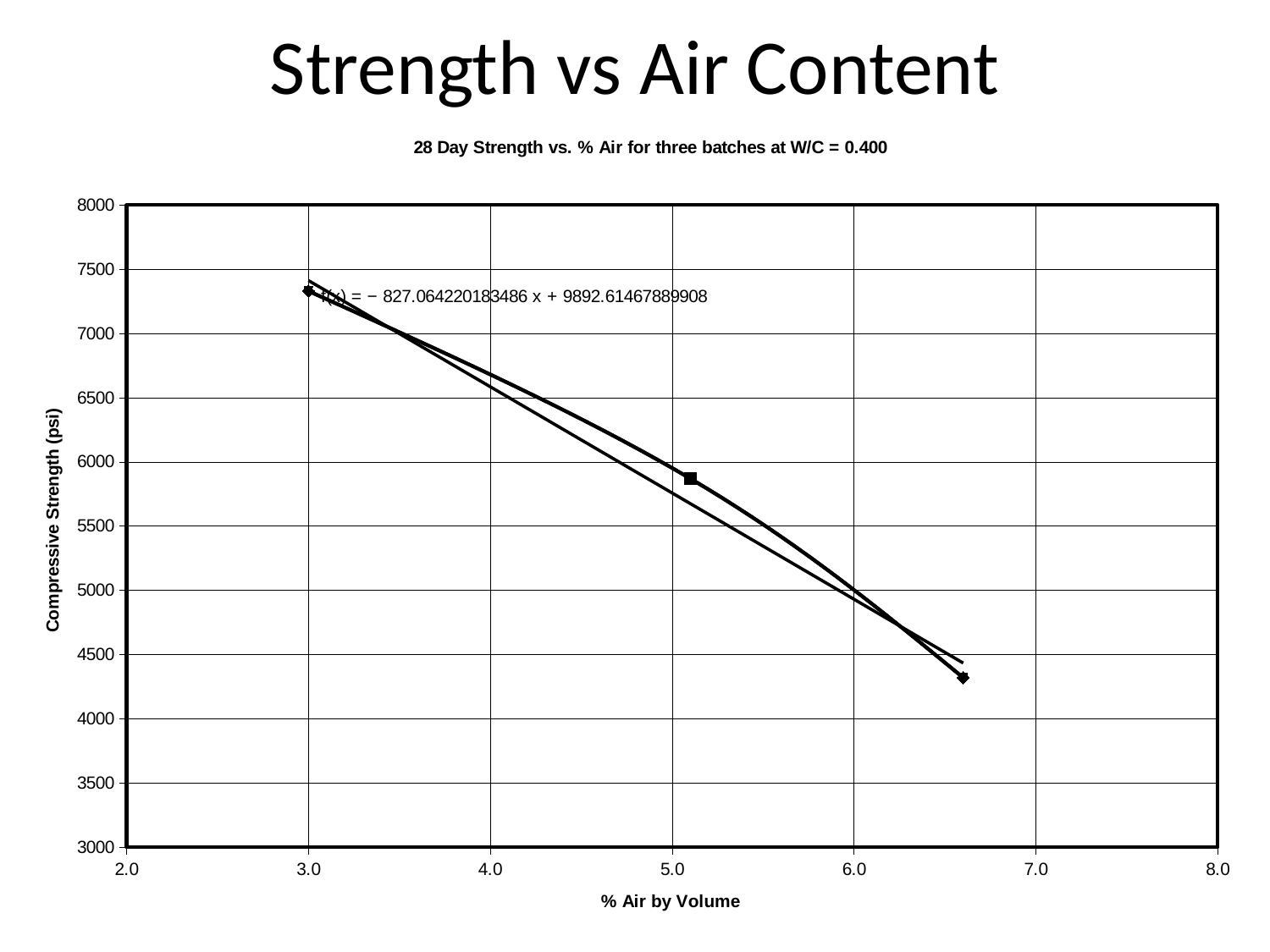
As % air by volume increases, does compressive strength rise or fall? fall Is the compressive strength of the data point at 3.0% air greater or less than 7000 psi? greater Is the compressive strength of the rightmost data point greater or less than 4500 psi? less Is the compressive strength of the middle data point greater or less than 6000 psi? less What is the title printed above the chart's plot area? 28 Day Strength vs. % Air for three batches at W/C = 0.400 What is the slope of the fitted line equation f(x) shown on the chart? −827.064220183486 Which has the higher compressive strength, the leftmost data point or the rightmost data point? the leftmost data point Which data point has the highest compressive strength? the point at 3.0% air Which data point has the lowest compressive strength? the point with the highest air content What kind of chart is shown on the slide? scatter chart How many data points are plotted on the chart? 3